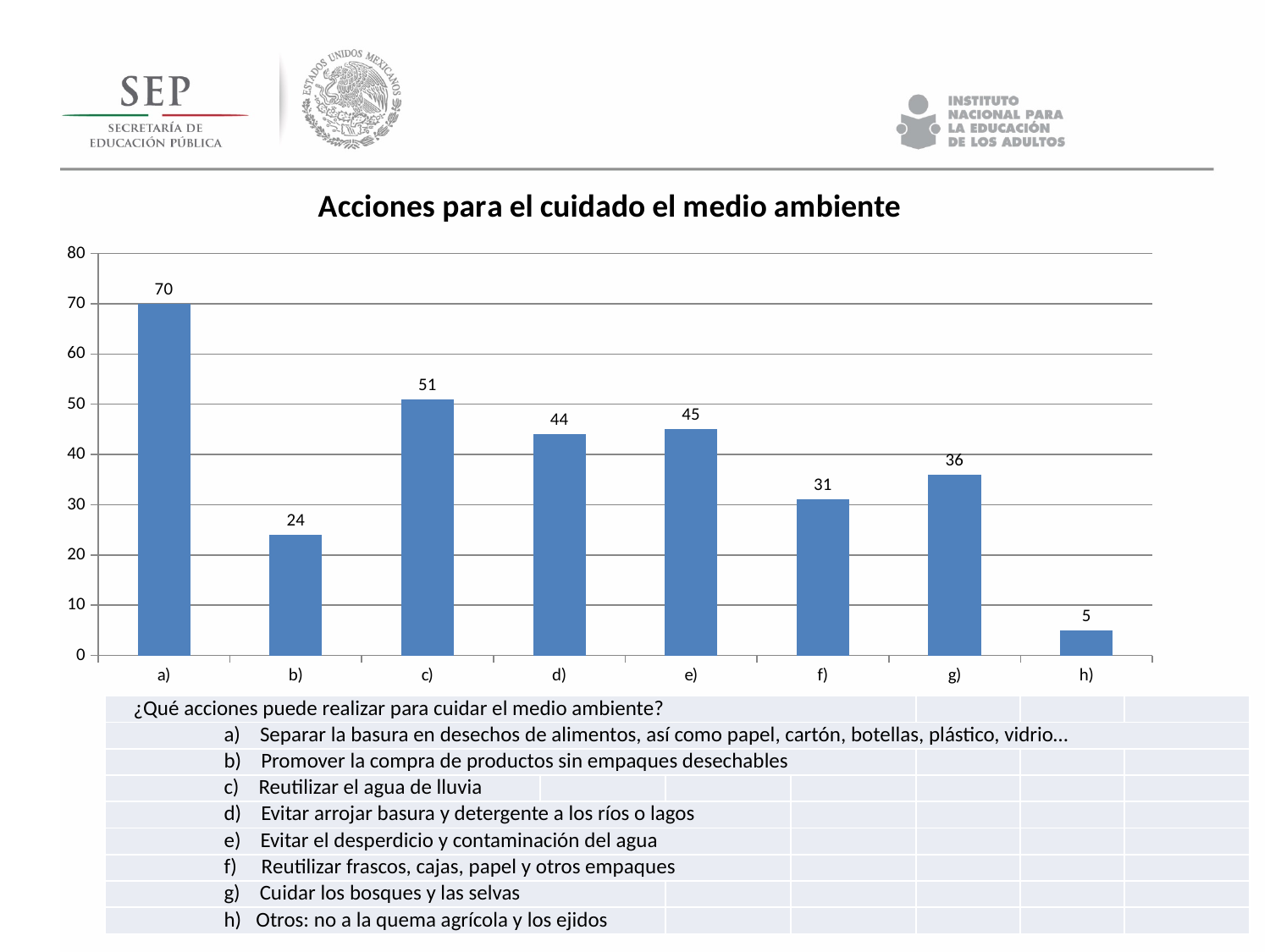
How many categories are shown on the x axis? 8 What is the difference between the values for a) and b)? 46 What is the value for category a)? 70 Which category has the lowest value? h) What is the title of the chart? Acciones para el cuidado el medio ambiente Is the value for g) greater or less than 40? less Which is larger, the value for d) or the value for e)? e) What is the value for category f)? 31 Which category has the highest value? a) What kind of chart is shown on the slide? bar chart What is the difference between the values for c) and g)? 15 What is the value for category h)? 5